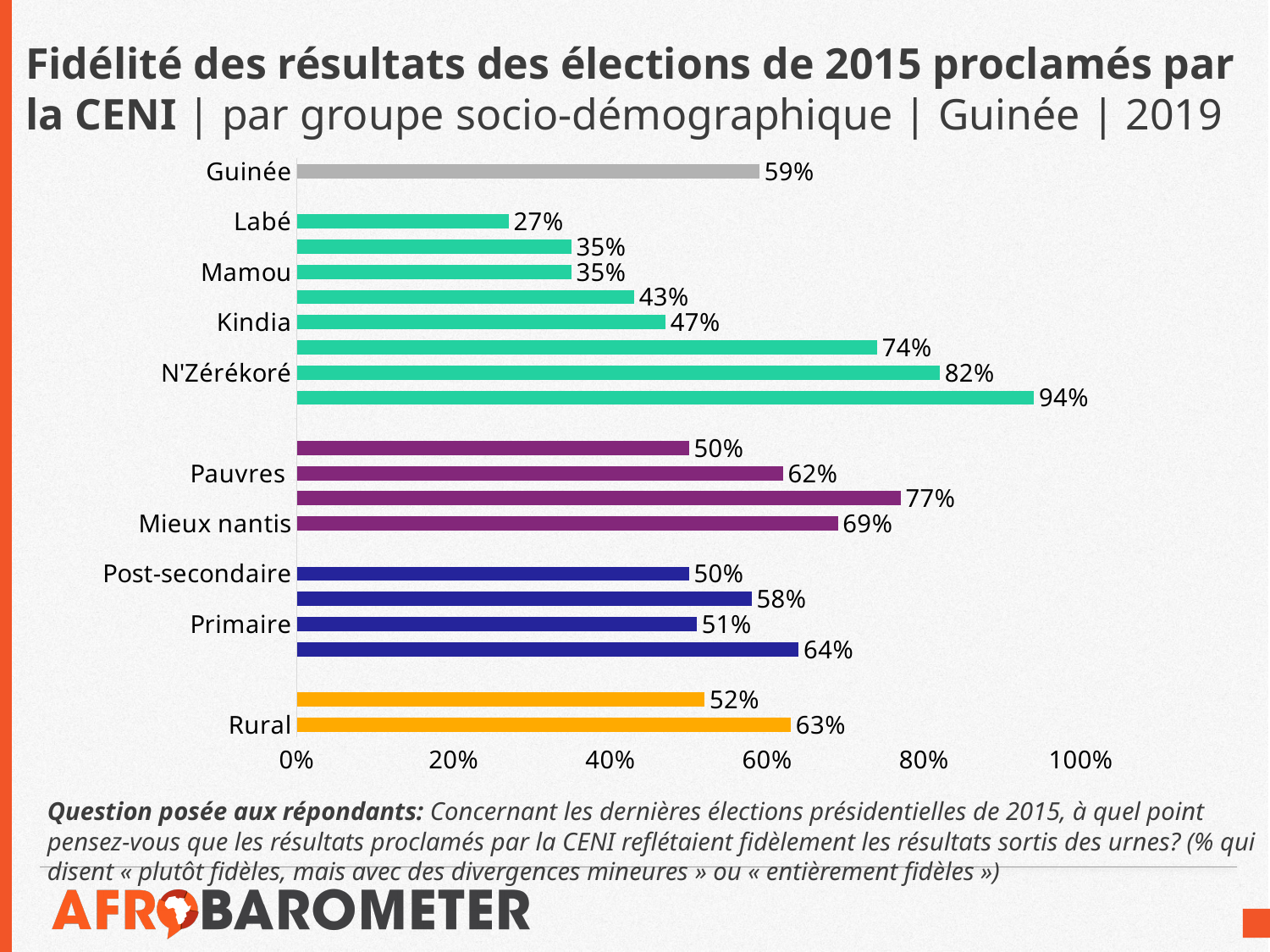
What is the value for Rural? 63% What is the value for Pauvres? 62% What is the value for N'Zérékoré? 82% What is the value for Post-secondaire? 50% What is the value for Mamou? 35% What is the value for Kindia? 47% What is the difference between the values for N'Zérékoré and Labé? 55 percentage points What is the value for Labé? 27% What is the value for Mieux nantis? 69% Which has the larger value, Pauvres or Mieux nantis? Mieux nantis What kind of chart is shown on the slide? Bar chart What is the value for Guinée? 59%